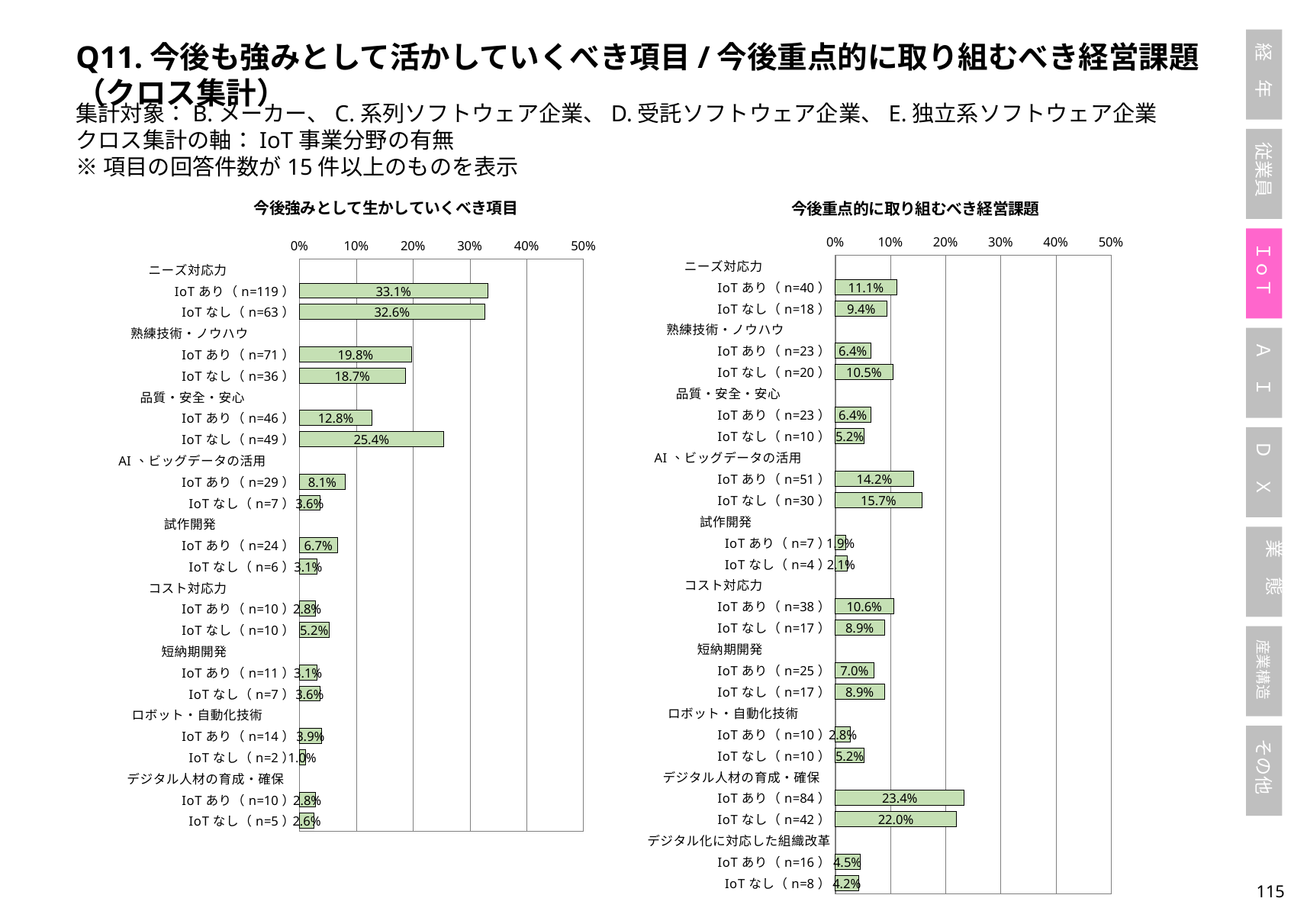
In the right chart (今後重点的に取り組むべき経営課題), is the value for デジタル人材の育成・確保 IoTなし (n=42) greater or less than 20%? greater What type of chart is used on this slide? bar chart In the right chart (今後重点的に取り組むべき経営課題), what is the value for AI、ビッグデータの活用 IoTなし (n=30)? 15.7% How many item groups (categories) are shown in the right chart (今後重点的に取り組むべき経営課題)? 10 What is the title of the left chart? 今後強みとして生かしていくべき項目 In the left chart (今後強みとして生かしていくべき項目), which bar has the highest value? ニーズ対応力 IoTあり (n=119) In the right chart (今後重点的に取り組むべき経営課題), what is the value for デジタル人材の育成・確保 IoTあり (n=84)? 23.4% In the left chart (今後強みとして生かしていくべき項目), what is the value for ニーズ対応力 IoTあり (n=119)? 33.1% In the left chart (今後強みとして生かしていくべき項目), what is the difference between 品質・安全・安心 IoTなし (n=49) and IoTあり (n=46)? 12.6% In the right chart (今後重点的に取り組むべき経営課題), which bar has the lowest value? 試作開発 IoTあり (n=7) In the left chart (今後強みとして生かしていくべき項目), what is the value for 品質・安全・安心 IoTなし (n=49)? 25.4% In the right chart (今後重点的に取り組むべき経営課題), which is larger: 熟練技術・ノウハウ IoTあり (n=23) or IoTなし (n=20)? IoTなし (n=20)